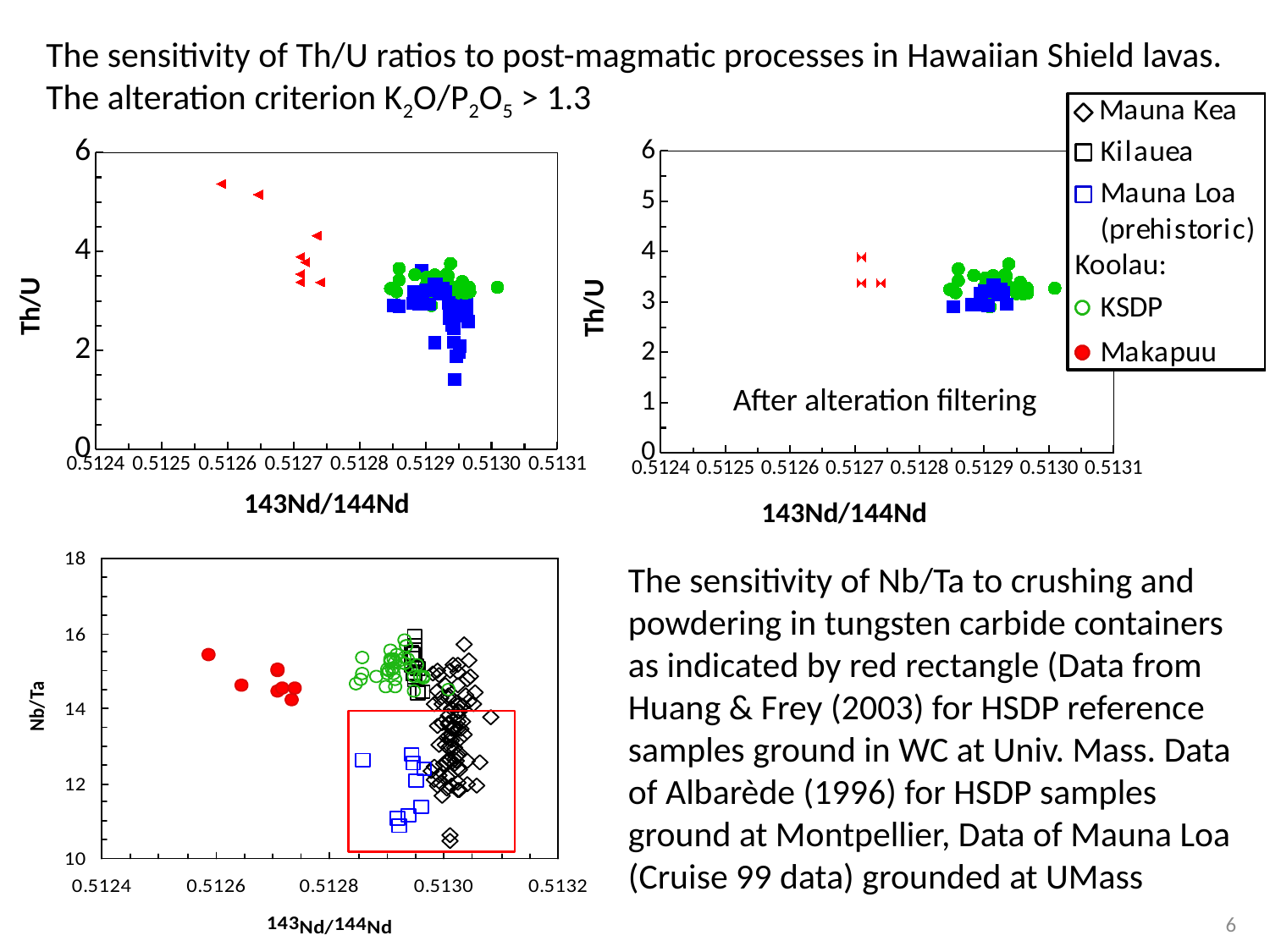
In the top-left chart, are the Th/U values of the red Makapuu points greater or less than 3? greater In the top-left chart, which series has points with Th/U values below 2? Mauna Loa (prehistoric) In the bottom-left chart, which series has lower Nb/Ta values, Mauna Loa (prehistoric) or KSDP? Mauna Loa (prehistoric) In the bottom-left chart, are the Nb/Ta values of the blue Mauna Loa (prehistoric) points greater or less than 14? less What is the y-axis label of the bottom-left chart? Nb/Ta In the top-right chart, are the Th/U values of the green KSDP points greater or less than 2? greater What kind of chart is the top-left chart (Th/U vs 143Nd/144Nd)? Scatter chart In the top-left chart, which series has higher Th/U values, Makapuu or Mauna Loa (prehistoric)? Makapuu Which two series are listed under 'Koolau:' in the legend? KSDP and Makapuu What is the maximum value shown on the y-axis of the bottom-left chart? 18